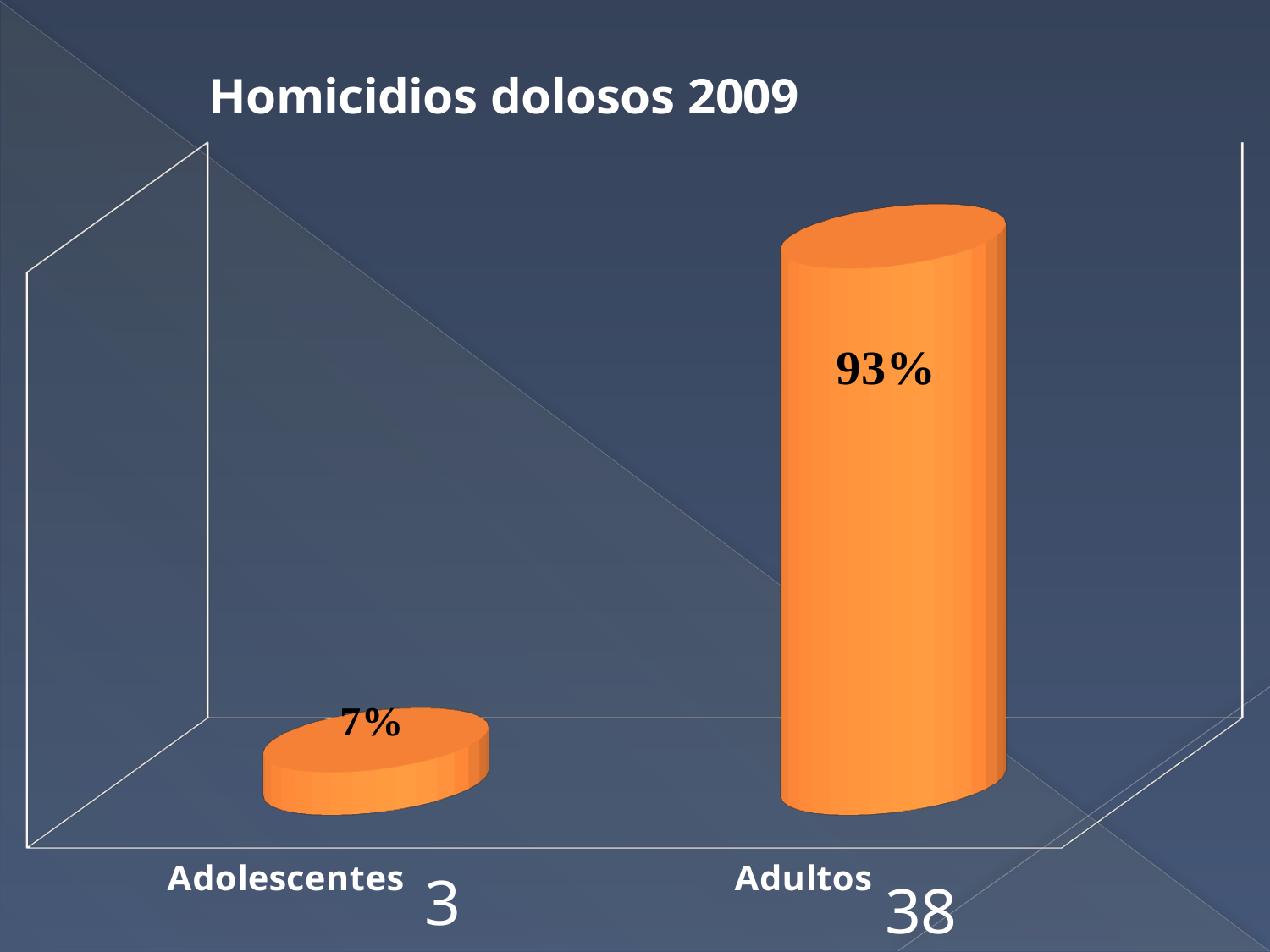
What is the title of the chart? Homicidios dolosos 2009 What type of chart is shown on the slide? bar chart What percentage is shown on the Adolescentes bar? 7% What value is printed for Adultos? 38 What percentage is shown on the Adultos bar? 93% Which category has the highest value? Adultos What colour are the bars in the chart? orange How many categories are shown in the chart? 2 What is the difference between the values for Adultos and Adolescentes? 35 Which category has the lowest value? Adolescentes Which is larger, the value for Adultos or the value for Adolescentes? Adultos What value is printed for Adolescentes? 3